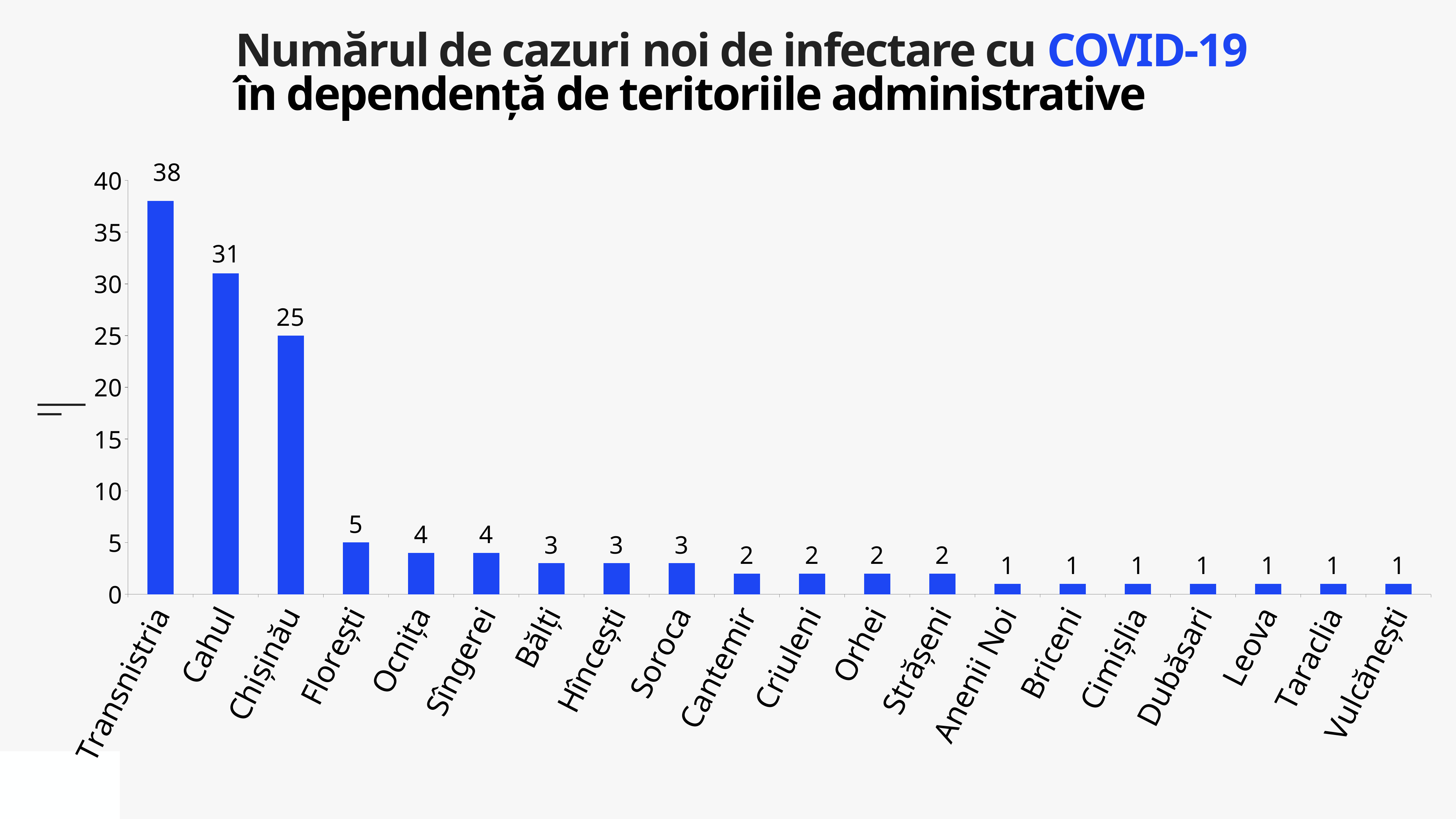
Is the value for Cahul greater or less than 30? greater What is the value for Florești? 5 What colour are the bars in the chart? blue Do the values rise or fall from left to right along the x axis? fall Which is larger, the value for Ocnița or the value for Bălți? Ocnița Which category has the highest value? Transnistria What kind of chart is shown on the slide? bar chart What is the difference between the values for Cahul and Chișinău? 6 What is the difference between the values for Transnistria and Cahul? 7 What is the value for Transnistria? 38 What is the value for Chișinău? 25 How many categories are shown on the x axis? 20